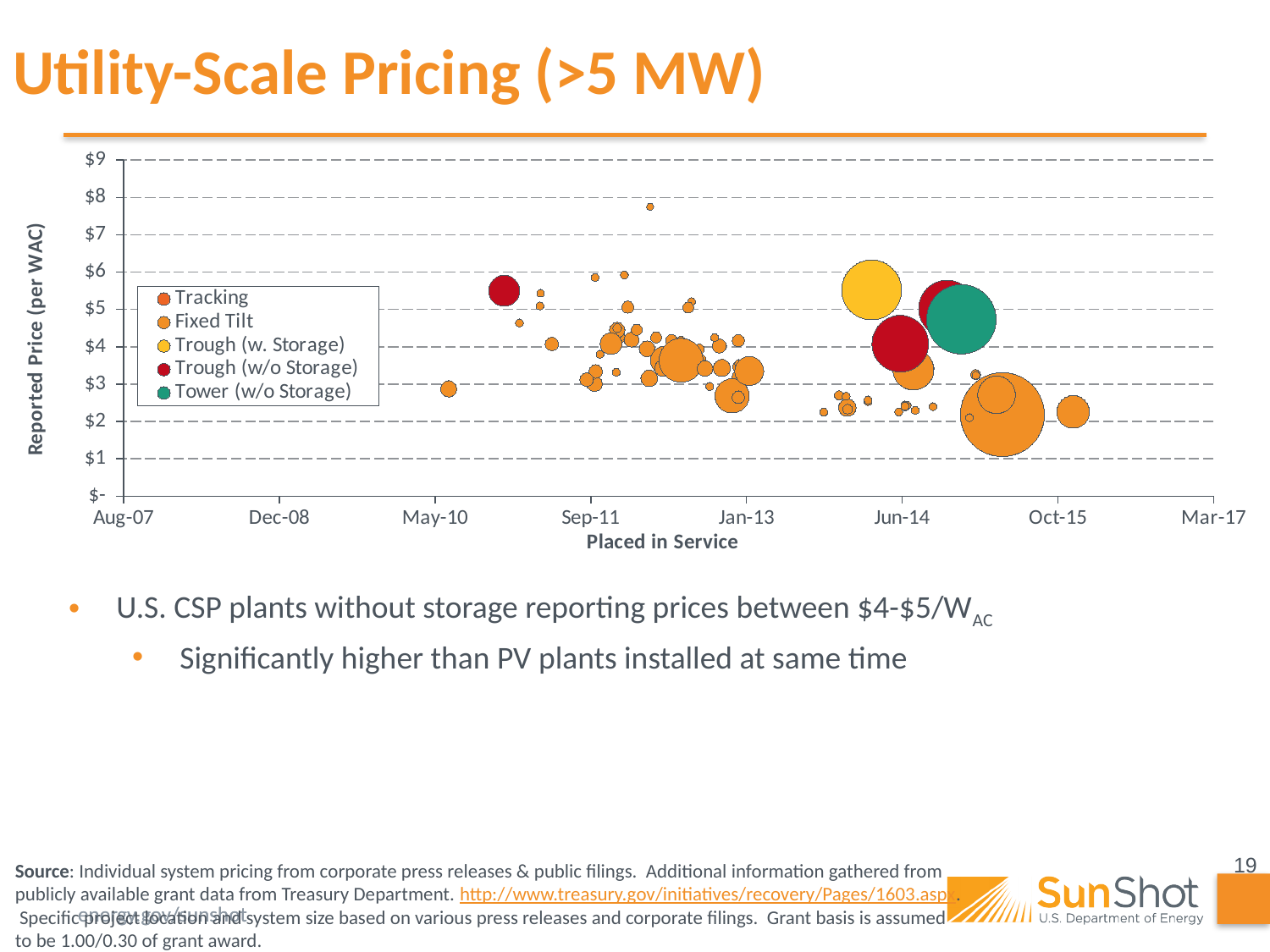
Is the price of the Tower (w/o Storage) bubble greater or less than $4? greater What kind of chart is shown on the slide? Bubble chart Is the price of the large Fixed Tilt bubble placed in service around mid-2015 greater or less than $3? less Which series has a higher price: Trough (w. Storage) or Tower (w/o Storage)? Trough (w. Storage) What is the highest value shown on the vertical axis of the chart? $9 Is the price of the Trough (w. Storage) bubble greater or less than $4? greater What is the title of the vertical axis of the chart? Reported Price (per WAC) How many series does the chart legend list? 5 What is the title of the horizontal axis of the chart? Placed in Service